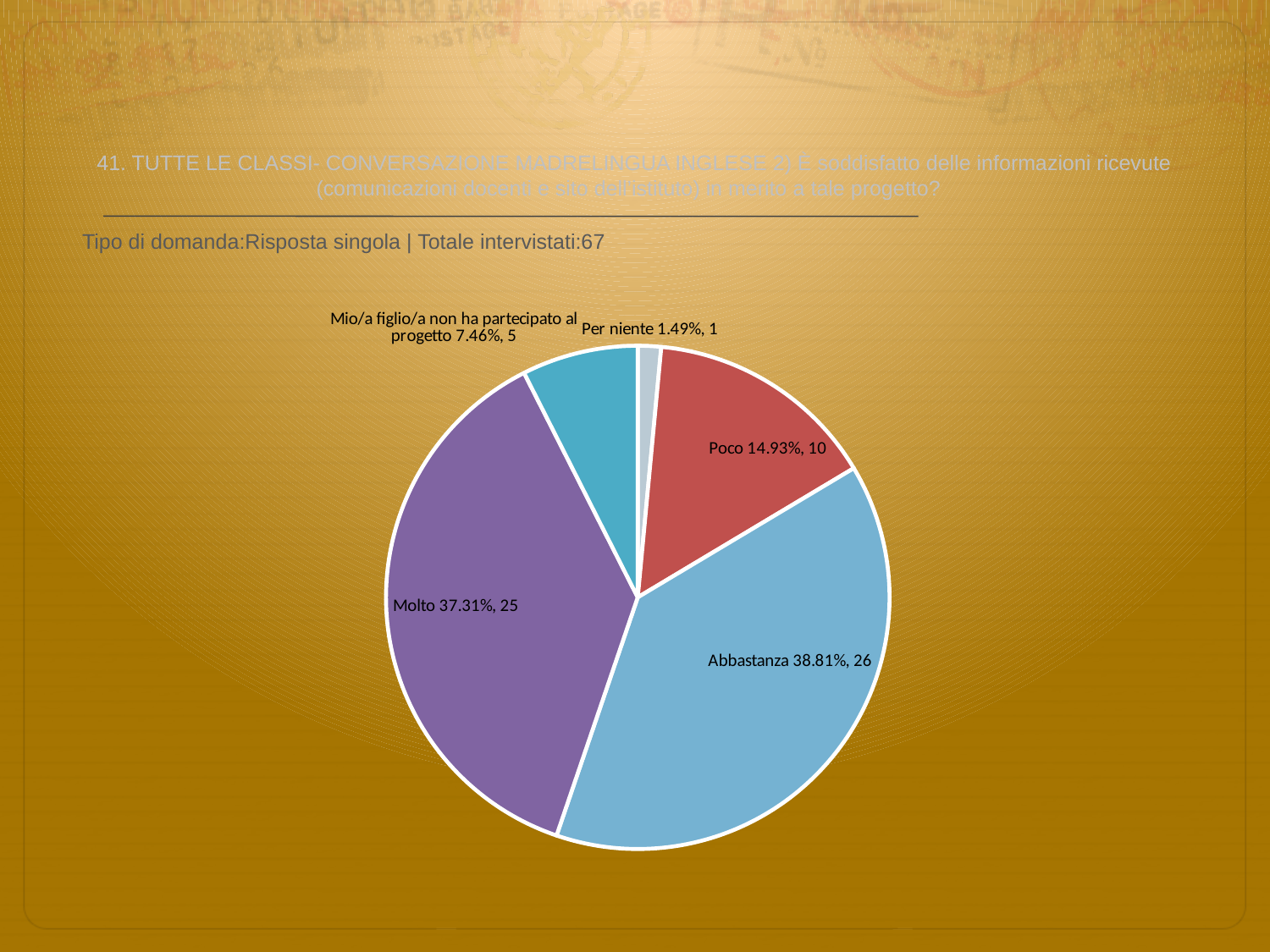
What kind of chart is shown on the slide? pie chart How many slices does the pie chart have? 5 How many respondents answered 'Poco'? 10 How many respondents answered 'Molto'? 25 What is the difference in count between 'Abbastanza' and 'Molto'? 1 What percentage share does the 'Abbastanza' slice have? 38.81% Which category has the smallest slice? Per niente Which is larger, the 'Poco' slice or the 'Mio/a figlio/a non ha partecipato al progetto' slice? Poco Which category has the largest slice? Abbastanza What colour is the 'Molto' slice? purple What percentage share does the 'Per niente' slice have? 1.49% What is the total number of respondents across all slices? 67